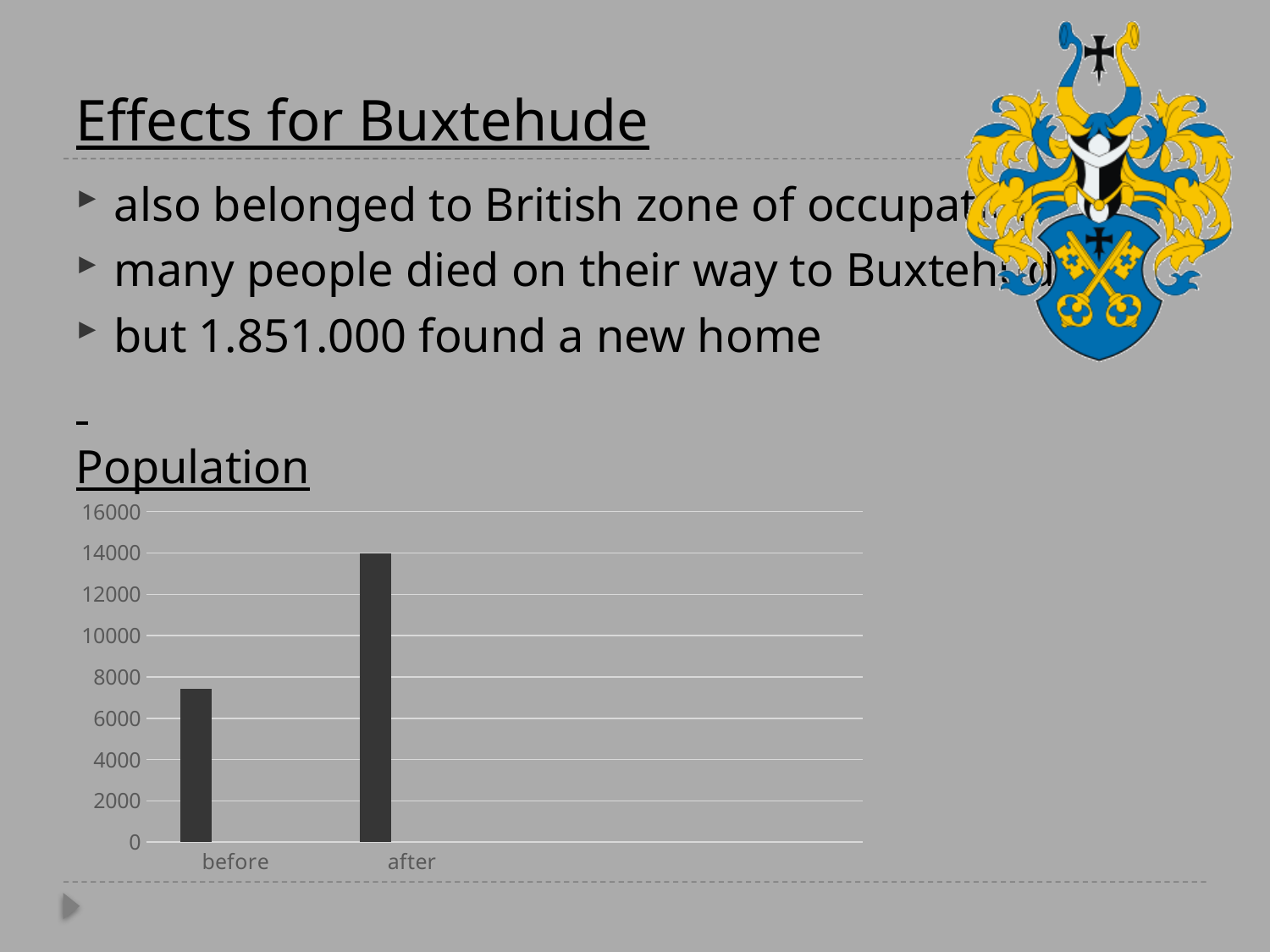
What is the highest value shown on the y axis of the chart? 16000 Is the value for after greater or less than 12000? greater Which is larger, the value for before or the value for after? after Which category has the lowest value in the chart? before Is the value for before greater or less than 6000? greater Is the value for after greater or less than 16000? less What is the title shown above the chart? Population Do the values rise or fall from before to after? rise How many categories are shown on the x axis of the chart? 2 Which category has the highest value in the chart? after What kind of chart is shown on the slide? bar chart